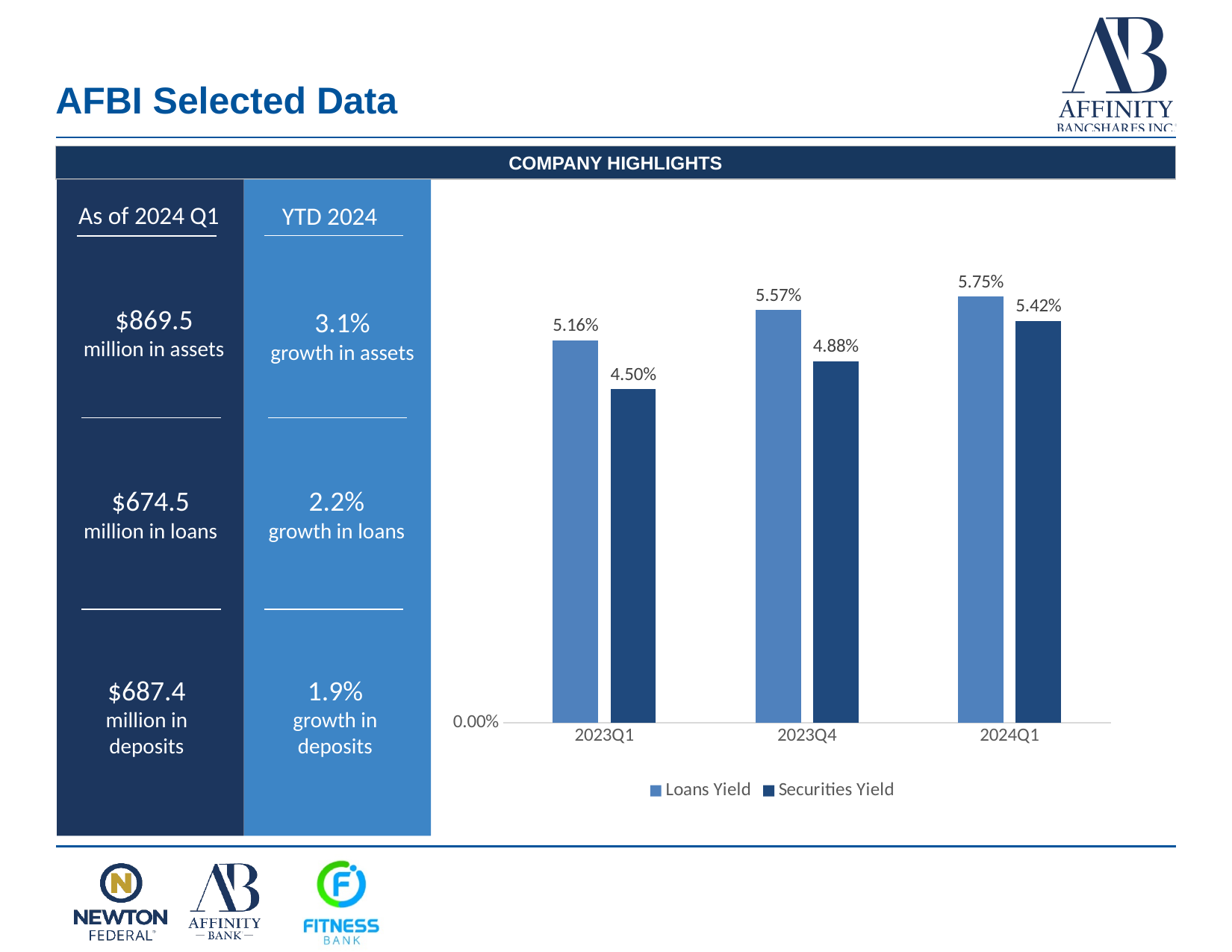
What is the Securities Yield for 2023Q4? 4.88% Does the Securities Yield rise or fall from 2023Q1 to 2024Q1? Rise What is the Loans Yield for 2024Q1? 5.75% What is the Loans Yield for 2023Q1? 5.16% How many periods are shown on the x axis of the chart? 3 What kind of chart is shown on the slide? Bar chart Which period has the highest Loans Yield? 2024Q1 What is the Securities Yield for 2023Q1? 4.50% Which period has the lowest Securities Yield? 2023Q1 How many series does the chart legend list? 2 What is the difference between the Loans Yield and the Securities Yield in 2024Q1? 0.33% Which is larger in 2023Q4, the Loans Yield or the Securities Yield? Loans Yield